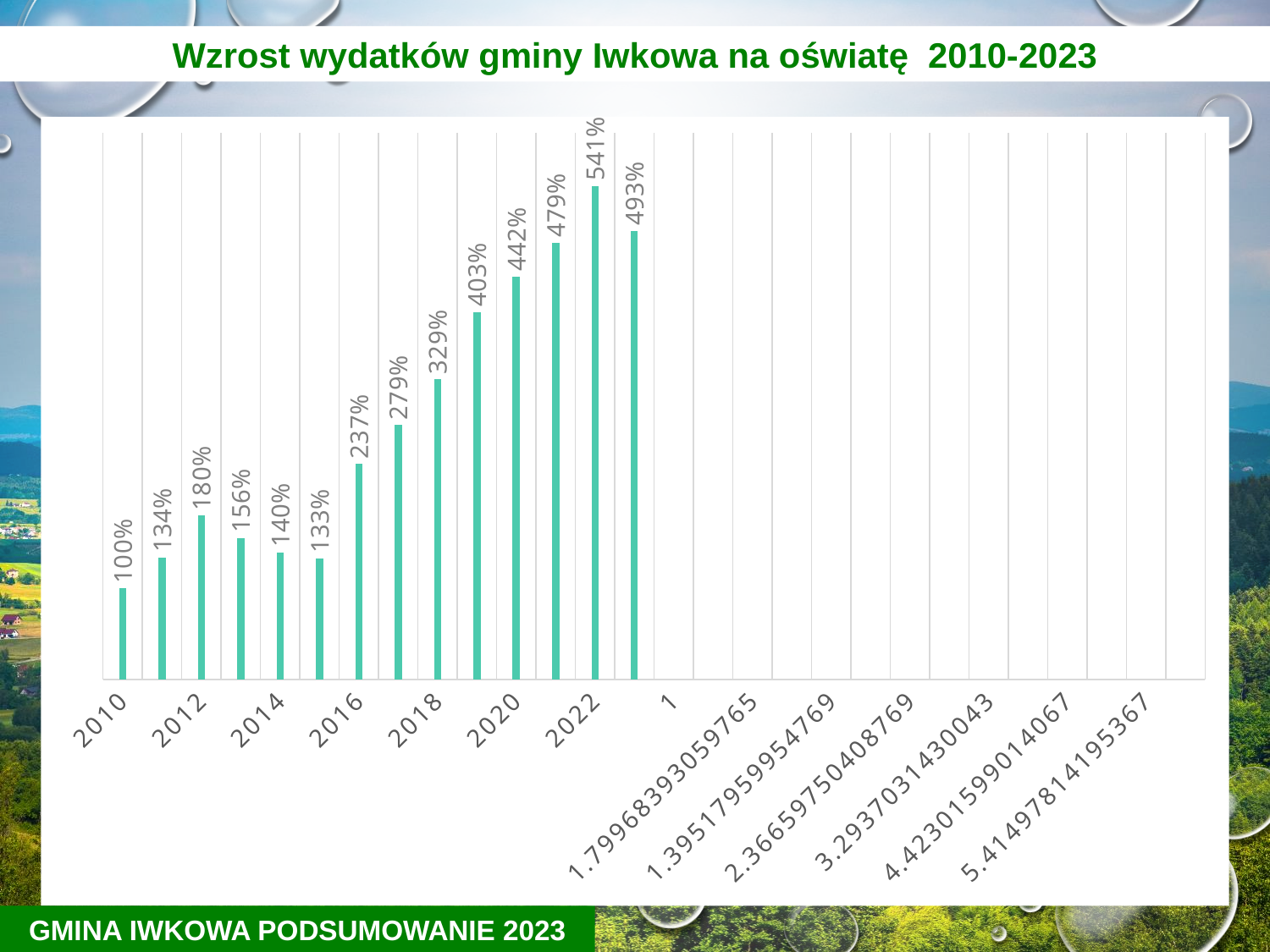
What is the value shown for 2016? 237% How many bars are plotted on the chart? 14 What is the difference between the values for 2022 and 2010? 441 percentage points What is the value shown for 2022? 541% What kind of chart is shown on the slide? Bar chart Which is larger, the value for 2018 or the value for 2014? 2018 What is the value shown for 2020? 442% What is the value shown for 2012? 180% Do the values generally rise or fall from 2010 to 2022? Rise Which year has the lowest value on the chart? 2010 Which year has the highest value on the chart? 2022 What is the value shown for 2010? 100%